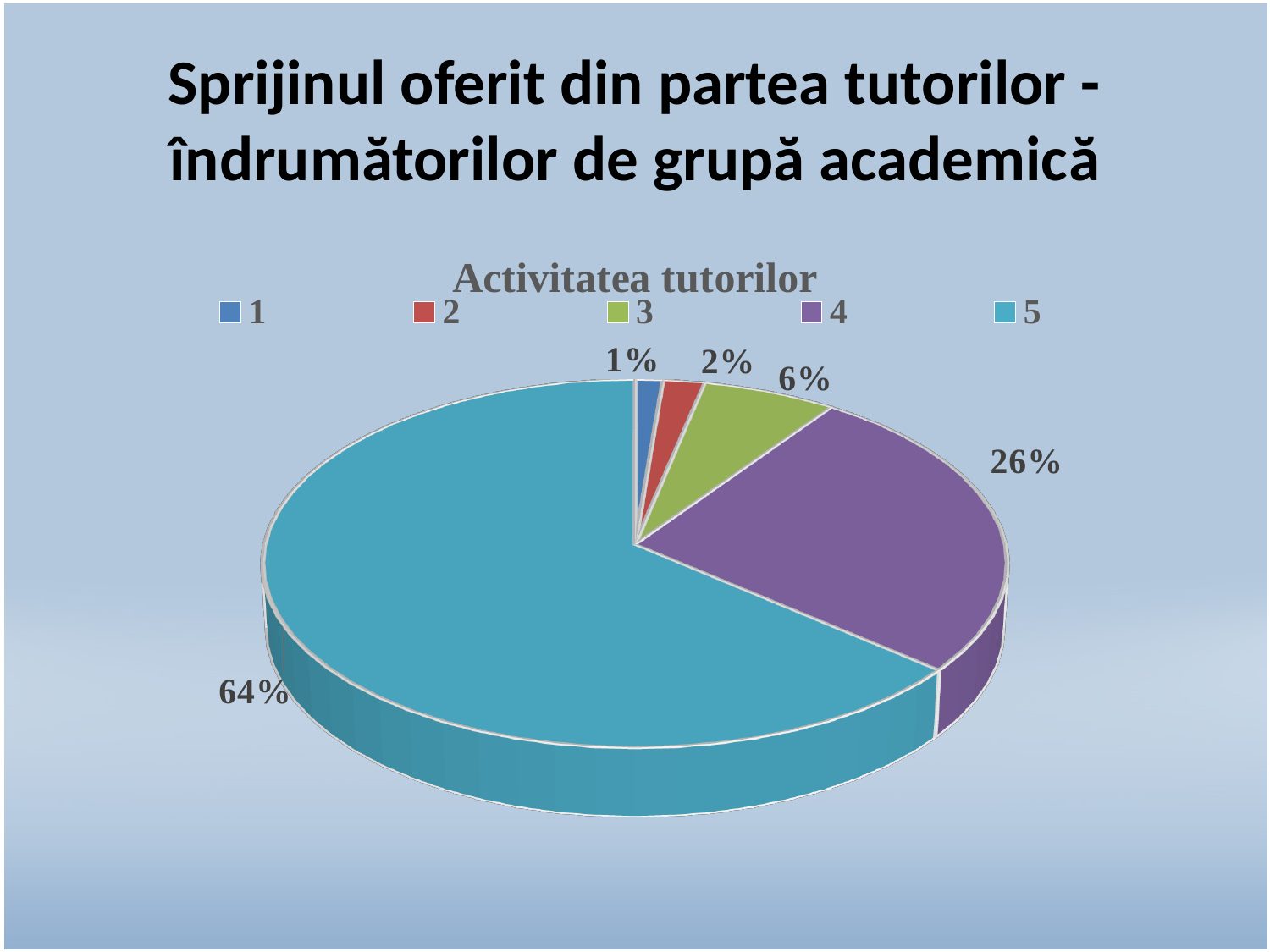
What is the value for category 2? 2% What share of the pie does category 5 have? 64% What is the difference between the shares of category 5 and category 4? 38% Which category has the largest slice? 5 What is the chart's title? Activitatea tutorilor What is the value for category 3? 6% Which category has the smallest slice? 1 What kind of chart is shown on the slide? pie chart What share of the pie does category 4 have? 26% How many categories does the legend list? 5 What is the value for category 1? 1% Which is larger, the slice for category 3 or the slice for category 4? 4